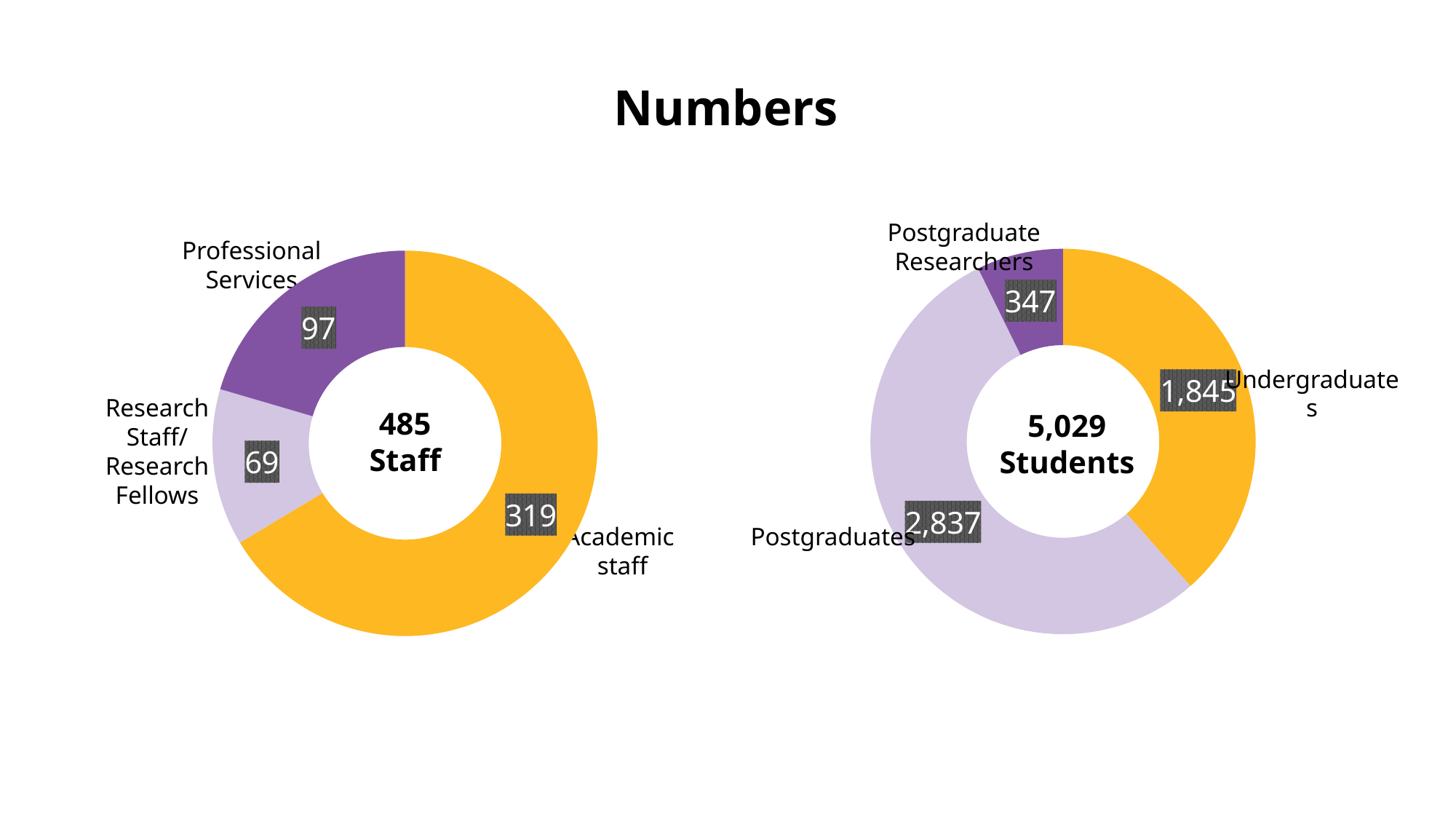
In the Students chart on the right, what is the value for Postgraduates? 2,837 In the Staff chart on the left, what is the value for Academic staff? 319 In the Students chart on the right, what is the value for Postgraduate Researchers? 347 In the Staff chart on the left, what is the difference between Academic staff and Professional Services? 222 How many categories does the Students chart on the right show? 3 In the Students chart on the right, what is the difference between Postgraduates and Undergraduates? 992 What total is shown in the centre of the Students chart on the right? 5,029 Students In the Students chart on the right, which category has the largest value? Postgraduates In the Staff chart on the left, what is the value for Professional Services? 97 What kind of chart is the Staff chart on the left? doughnut chart In the Staff chart on the left, which category has the smallest value? Research Staff/Research Fellows In the Staff chart on the left, which is larger, Professional Services or Research Staff/Research Fellows? Professional Services